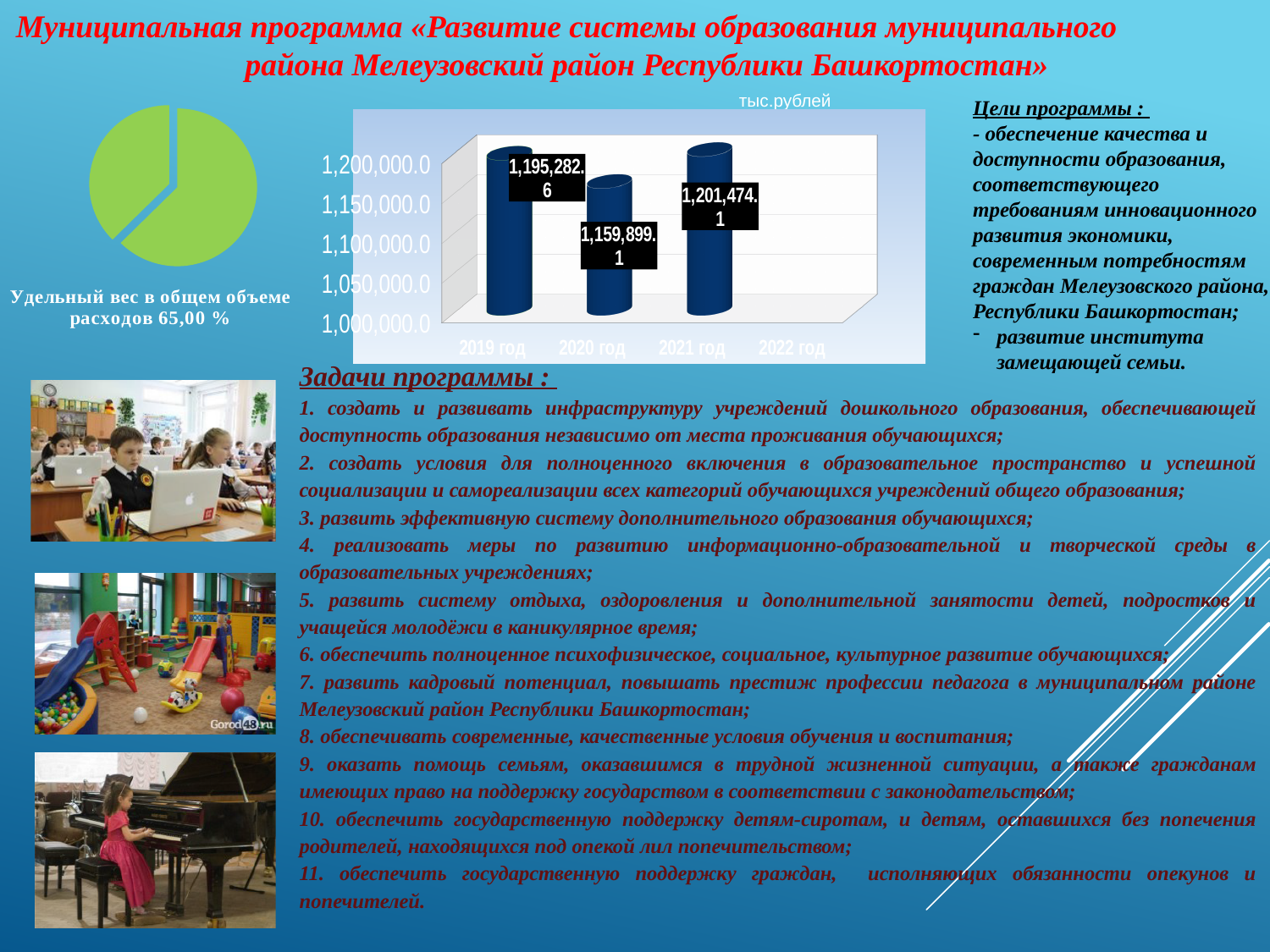
In the bar chart, which year has the lowest value? 2020 год How many bars are plotted in the bar chart? 3 What unit label is shown above the bar chart? тыс.рублей In the bar chart, is the value for 2020 год greater or less than 1,200,000.0? less In the bar chart, what is the difference between the values for 2019 год and 2020 год? 35,383.5 In the bar chart, what is the value for 2021 год? 1,201,474.1 In the bar chart, what is the value for 2020 год? 1,159,899.1 What kind of chart is the chart in the top centre of the slide? bar chart In the bar chart, which year has the highest value? 2021 год In the bar chart, what is the value for 2019 год? 1,195,282.6 In the bar chart, which is larger: the value for 2019 год or 2021 год? 2021 год In the bar chart, what is the difference between the values for 2021 год and 2020 год? 41,575.0